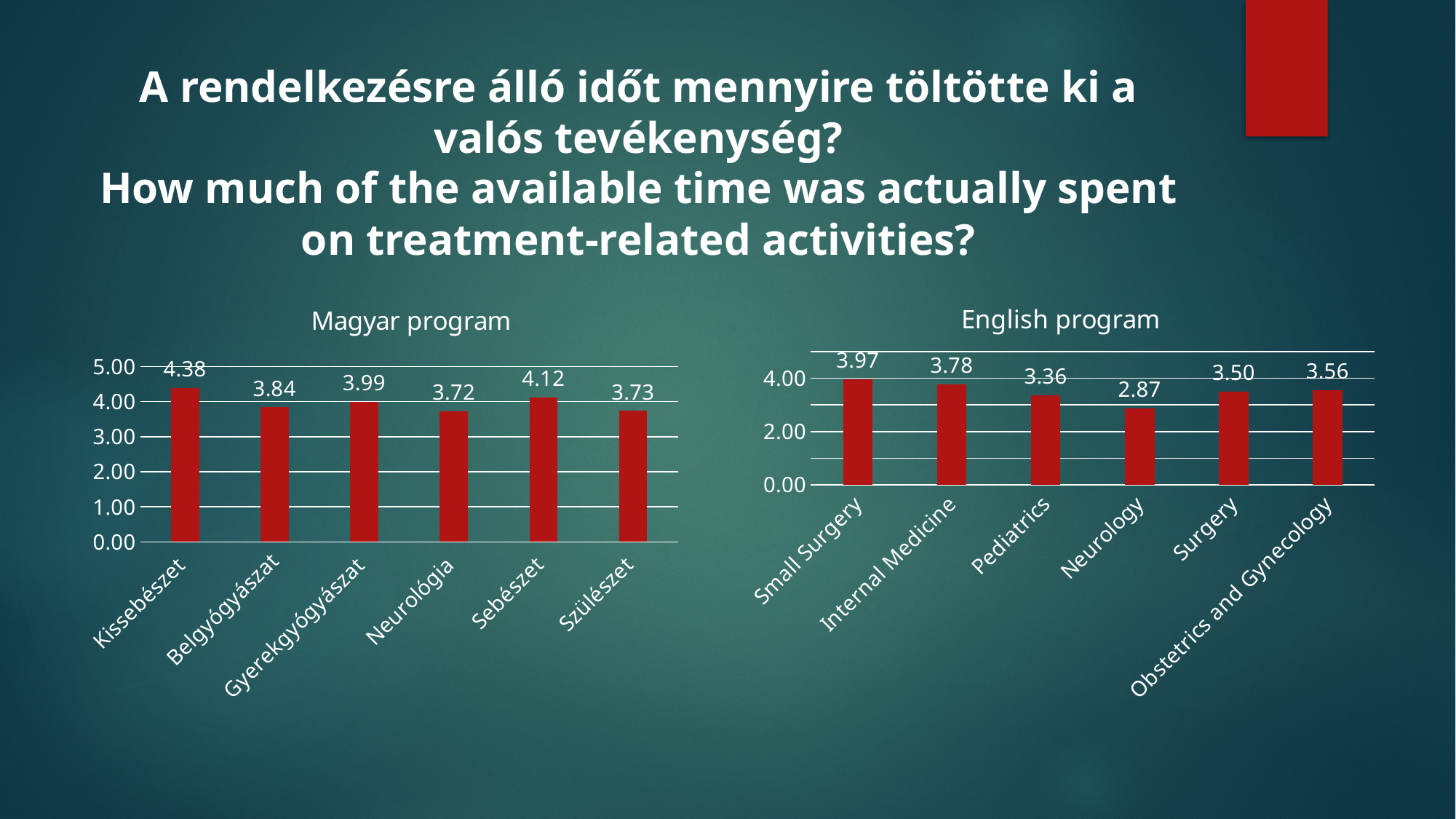
What kind of chart is the English program chart? Bar chart In the Magyar program chart, how many categories are shown? 6 In the English program chart, what is the difference between the values for Small Surgery and Surgery? 0.47 In the Magyar program chart, what is the value for Kissebészet? 4.38 In the Magyar program chart, which category has the lowest value? Neurológia In the English program chart, what is the value for Neurology? 2.87 In the English program chart, which category has the lowest value? Neurology In the Magyar program chart, which category has the highest value? Kissebészet In the English program chart, which is larger, the value for Internal Medicine or the value for Pediatrics? Internal Medicine In the English program chart, which category has the highest value? Small Surgery In the Magyar program chart, what is the difference between the values for Kissebészet and Neurológia? 0.66 In the English program chart, what is the value for Obstetrics and Gynecology? 3.56